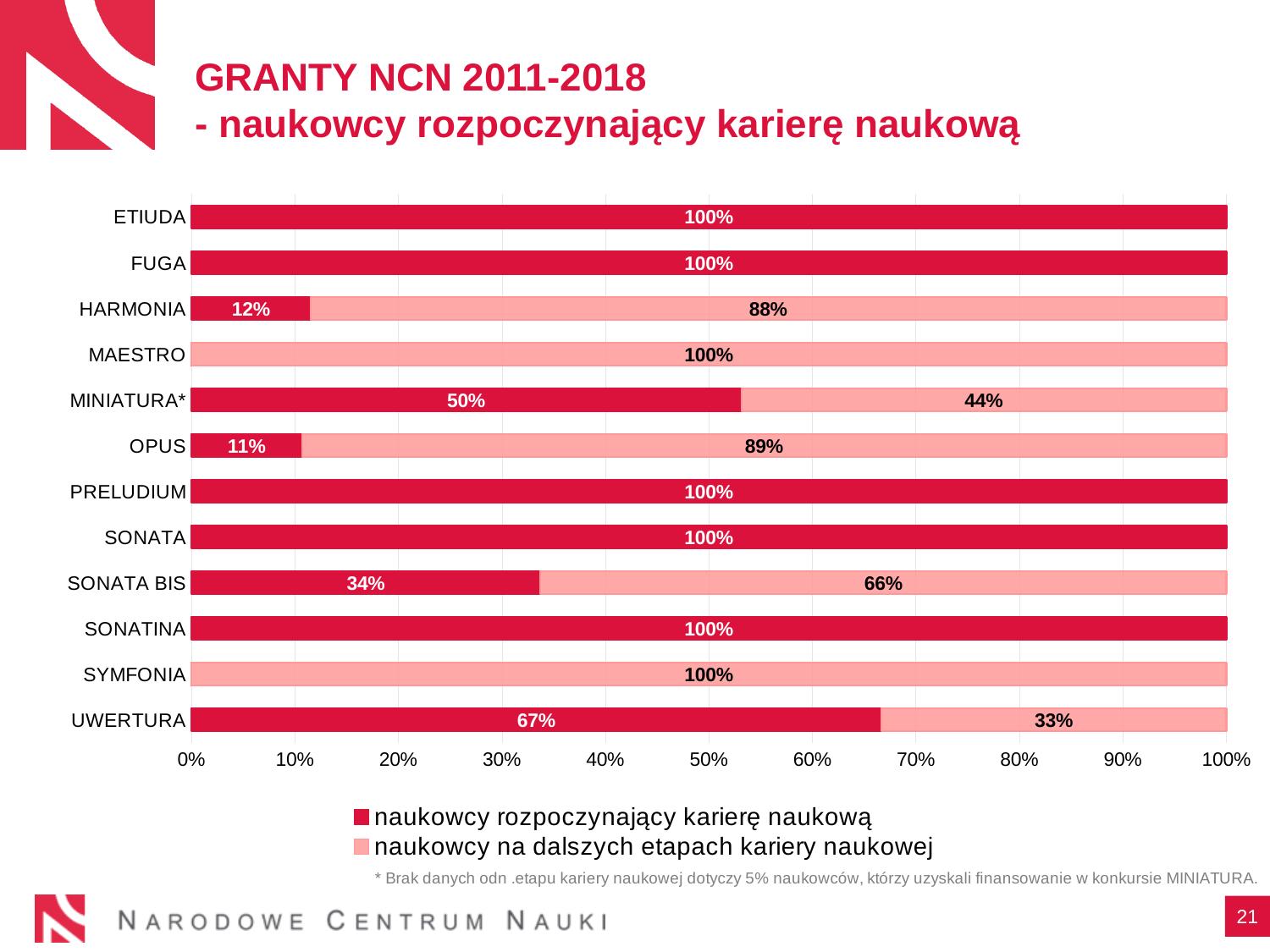
What kind of chart is shown on the slide? stacked bar chart Which is larger for SONATA BIS: the share of 'naukowcy rozpoczynający karierę naukową' or 'naukowcy na dalszych etapach kariery naukowej'? naukowcy na dalszych etapach kariery naukowej What is the share of 'naukowcy na dalszych etapach kariery naukowej' for OPUS? 89% What is the share of 'naukowcy rozpoczynający karierę naukową' for UWERTURA? 67% How many series does the legend list? 2 What is the share of 'naukowcy na dalszych etapach kariery naukowej' for SONATA BIS? 66% How many grant programmes (categories) are shown on the chart? 12 Which programmes show 100% for 'naukowcy na dalszych etapach kariery naukowej'? MAESTRO and SYMFONIA What is the total of the two segments of the MINIATURA* bar? 94% What is the share of 'naukowcy rozpoczynający karierę naukową' for HARMONIA? 12% What is the difference between the two segments of the MINIATURA* bar? 6% Which programme has the lowest share of 'naukowcy rozpoczynający karierę naukową' among those with a non-zero value? OPUS